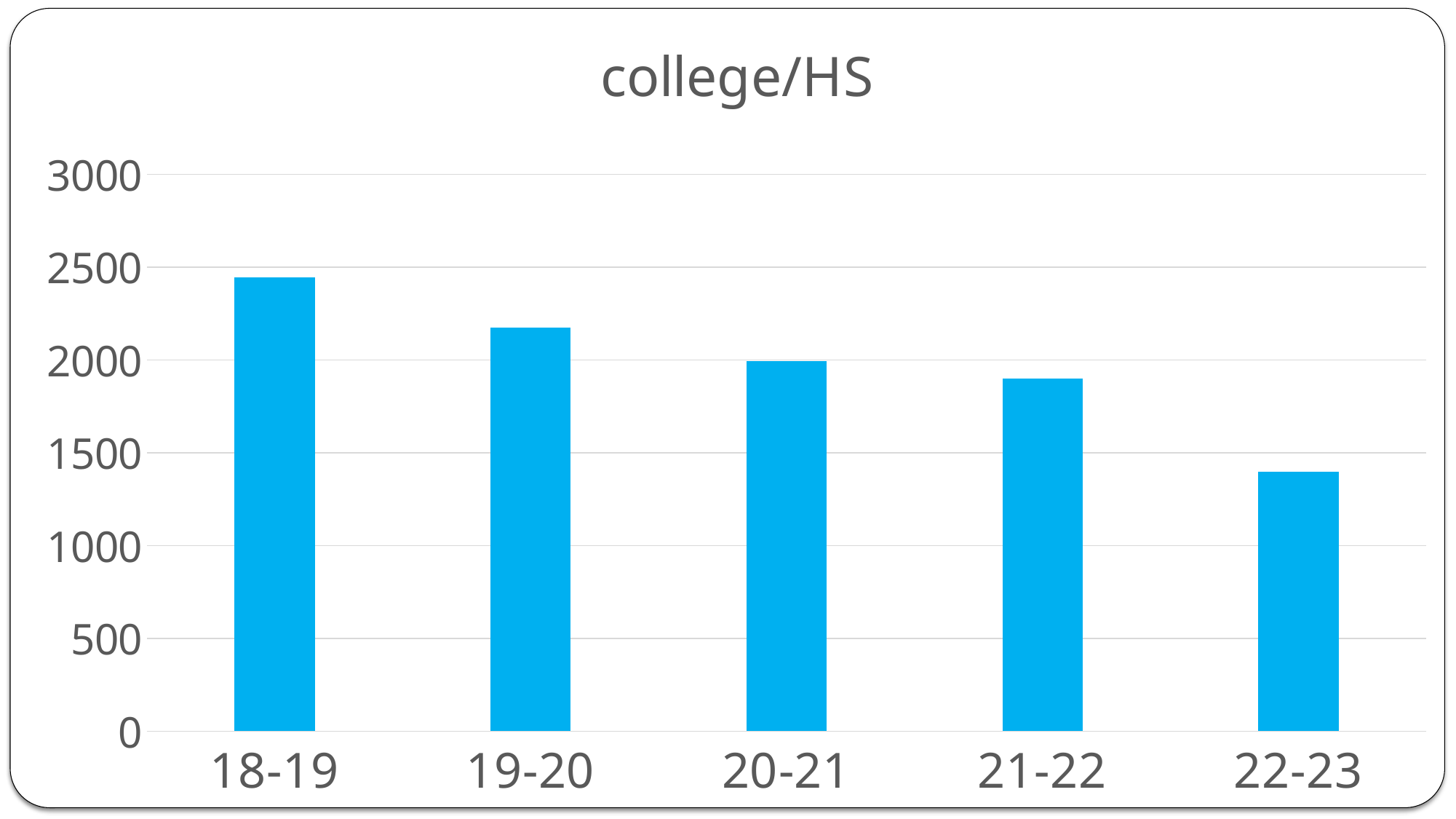
Is the value for 18-19 greater or less than 2000? greater Which is larger, the value for 19-20 or the value for 21-22? 19-20 Do the values rise or fall from 18-19 to 22-23? fall Which is larger, the value for 18-19 or the value for 22-23? 18-19 Which category has the lowest value in the chart? 22-23 Is the value for 22-23 greater or less than 1500? less What is the title of the chart? college/HS What kind of chart is shown on the slide? bar chart Which category has the highest value in the chart? 18-19 Is the value for 19-20 greater or less than 2000? greater How many categories are shown on the x axis of the chart? 5